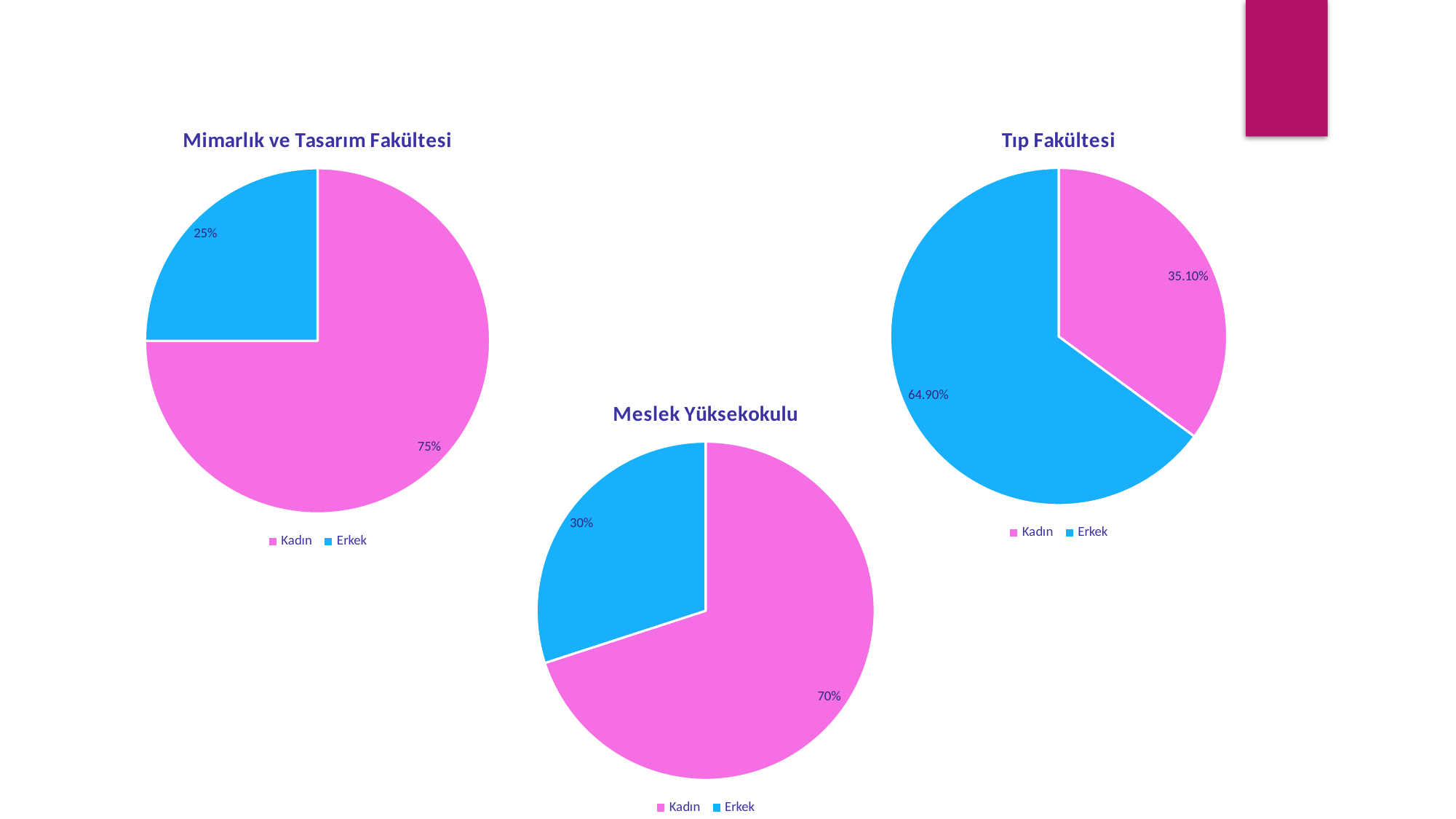
In the 'Meslek Yüksekokulu' chart, what share does Kadın have? 70% How many categories does the legend of the 'Tıp Fakültesi' chart list? 2 In the 'Meslek Yüksekokulu' chart, which category has the smallest slice? Erkek In the 'Meslek Yüksekokulu' chart, what share does Erkek have? 30% In the 'Tıp Fakültesi' chart, which category has the largest slice? Erkek What kind of chart is the 'Meslek Yüksekokulu' chart? Pie chart In the 'Tıp Fakültesi' chart, what share does Erkek have? 64.90% In the 'Mimarlık ve Tasarım Fakültesi' chart, what share does Kadın have? 75% In the 'Mimarlık ve Tasarım Fakültesi' chart, what is the difference between the Kadın and Erkek shares? 50% In the 'Mimarlık ve Tasarım Fakültesi' chart, what share does Erkek have? 25% In the 'Tıp Fakültesi' chart, what share does Kadın have? 35.10% In the 'Tıp Fakültesi' chart, which is larger, Kadın or Erkek? Erkek